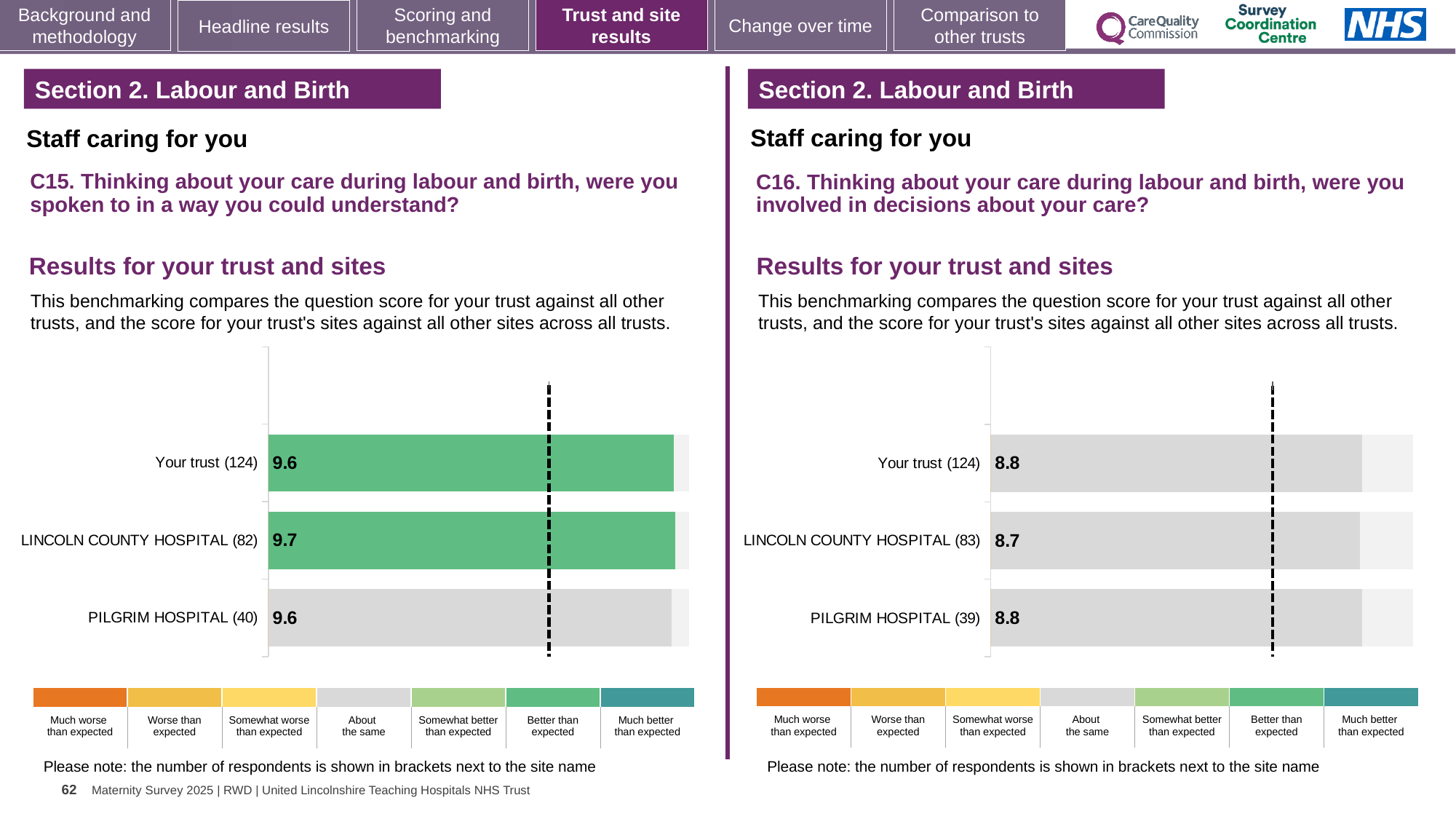
On the left chart (C15), which row has the highest score? LINCOLN COUNTY HOSPITAL How many rows (bars) are plotted on the right chart (C16)? 3 On the left chart (C15), what is the score for Your trust? 9.6 On the right chart (C16), what is the score for LINCOLN COUNTY HOSPITAL? 8.7 On the left chart (C15), what is the score for PILGRIM HOSPITAL? 9.6 On the left chart (C15), what is the difference between the LINCOLN COUNTY HOSPITAL score and the PILGRIM HOSPITAL score? 0.1 On the right chart (C16), how many respondents are shown in brackets for PILGRIM HOSPITAL? 39 On the right chart (C16), what is the score for PILGRIM HOSPITAL? 8.8 On the right chart (C16), what is the score for Your trust? 8.8 What type of chart is used on the left (C15)? Bar chart On the left chart (C15), what is the score for LINCOLN COUNTY HOSPITAL? 9.7 On the right chart (C16), which row has the lowest score? LINCOLN COUNTY HOSPITAL